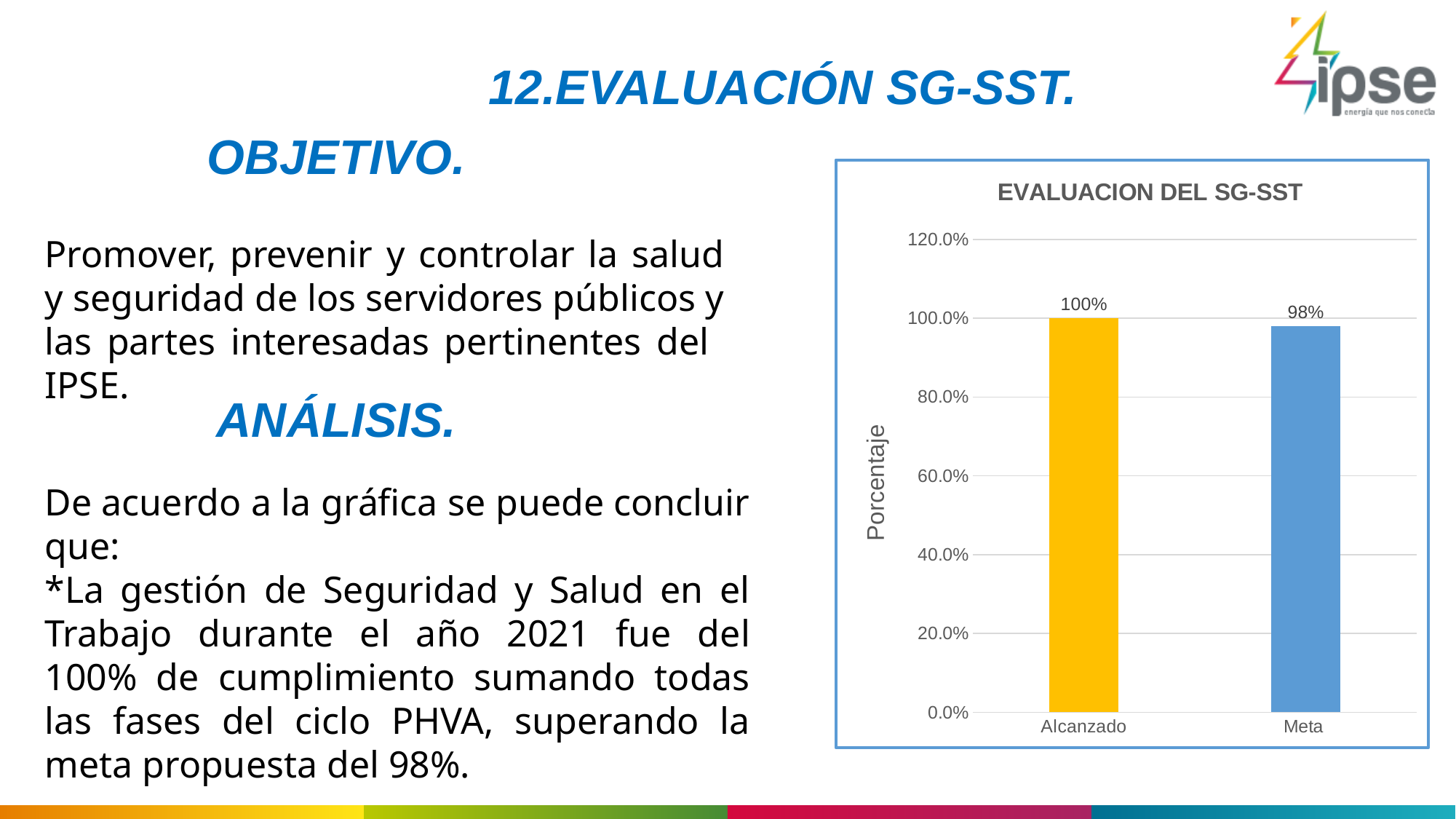
Which category has the lowest value in the chart? Meta What is the label of the vertical axis of the chart? Porcentaje What is the value for Meta in the chart? 98% What is the value for Alcanzado in the chart? 100% What kind of chart is shown on the slide? Bar chart How many categories are shown on the x axis of the chart? 2 What is the highest tick value shown on the vertical axis? 120.0% Is the value for Meta greater or less than 80.0%? greater Which category has the higher value, Alcanzado or Meta? Alcanzado What is the difference between the Alcanzado and Meta values? 2% What is the title of the chart? EVALUACION DEL SG-SST